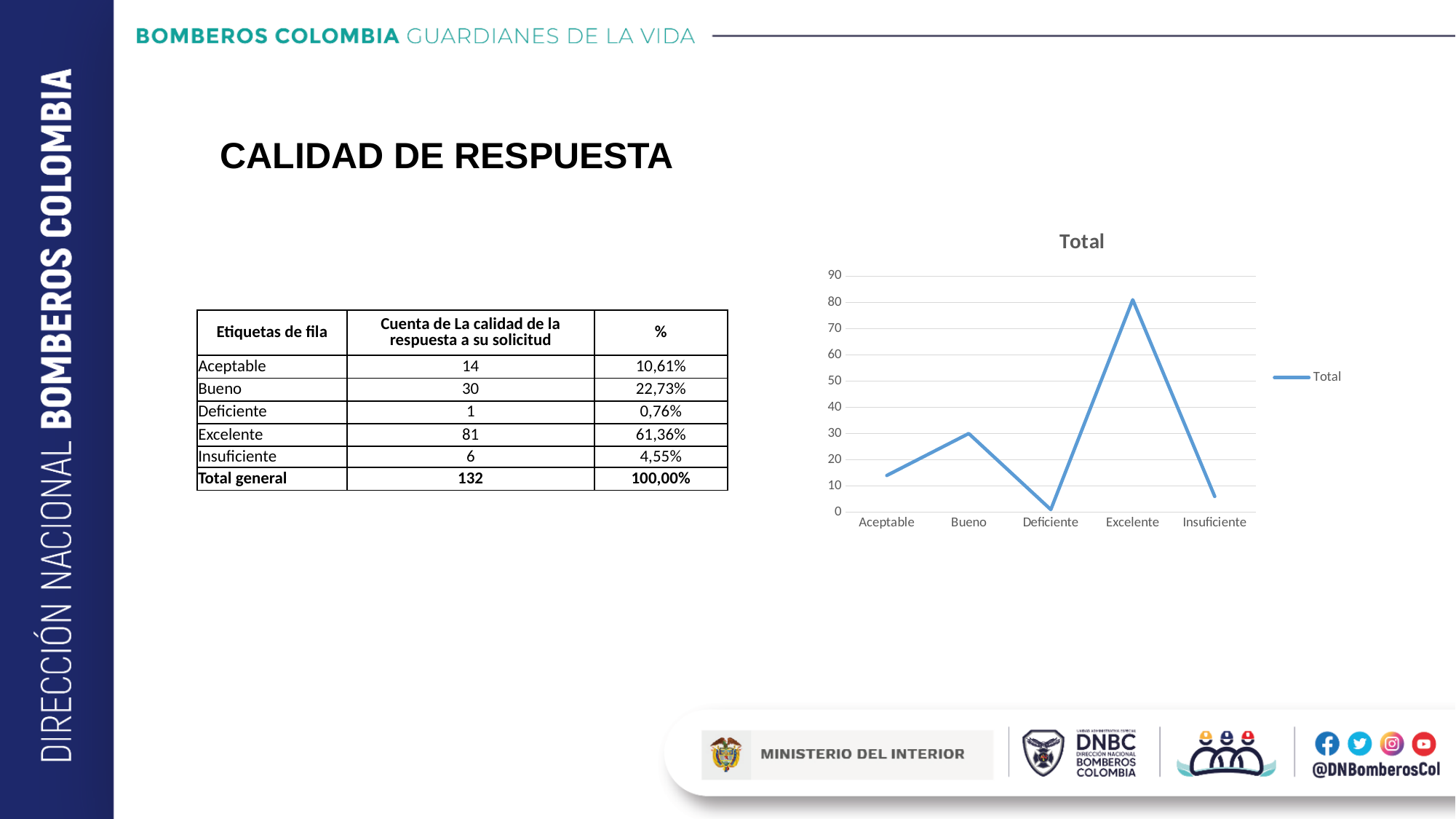
What kind of chart is shown on the slide? line chart How many series does the chart legend list? 1 What is the title of the chart? Total Which category has the lowest value in the chart? Deficiente Is the value for Aceptable greater or less than 20? less Does the line rise or fall from Excelente to Insuficiente? fall What is the value for Bueno in the chart? 30 Is the value for Excelente greater or less than 70? greater Which is larger, the value for Bueno or the value for Aceptable? Bueno Is the value for Insuficiente greater or less than 10? less Which category has the highest value in the chart? Excelente How many categories are plotted along the x axis of the chart? 5